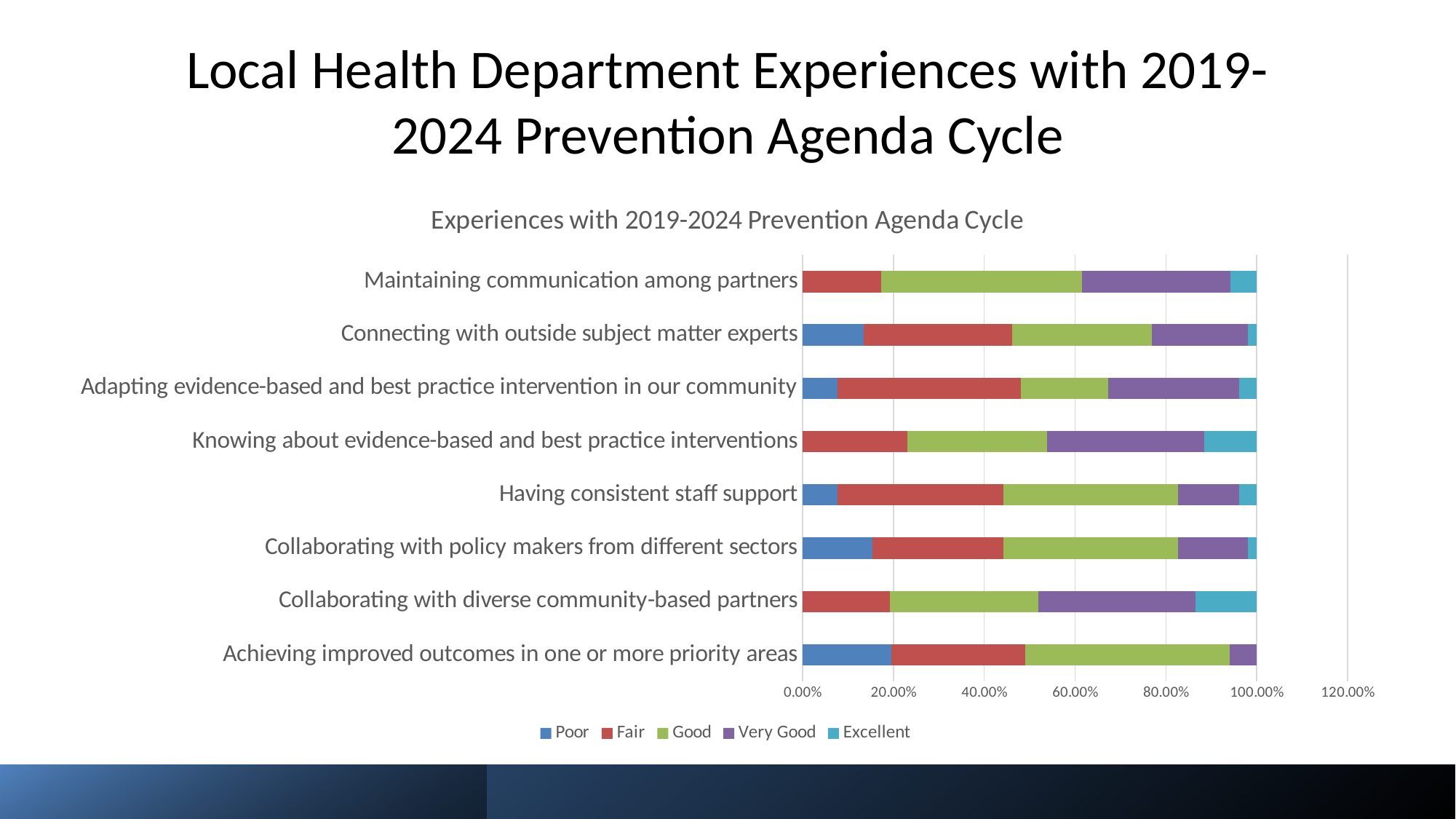
How many series does the legend list? 5 Is the 'Poor' value for 'Connecting with outside subject matter experts' greater or less than 20.00%? less Which category has the largest 'Poor' segment? Achieving improved outcomes in one or more priority areas What is the title of the chart? Experiences with 2019-2024 Prevention Agenda Cycle Which is larger: the 'Poor' value for 'Achieving improved outcomes in one or more priority areas' or the 'Poor' value for 'Connecting with outside subject matter experts'? Achieving improved outcomes in one or more priority areas Is the 'Fair' value for 'Maintaining communication among partners' greater or less than 20.00%? less Is the 'Poor' value for 'Adapting evidence-based and best practice intervention in our community' greater or less than 20.00%? less How many categories (bars) are plotted in the chart? 8 Which category has no 'Excellent' segment in its bar? Achieving improved outcomes in one or more priority areas Which is larger: the 'Fair' value for 'Knowing about evidence-based and best practice interventions' or the 'Fair' value for 'Maintaining communication among partners'? Knowing about evidence-based and best practice interventions What kind of chart is shown on the slide? Stacked bar chart Which colour represents the 'Very Good' series in the legend? Purple